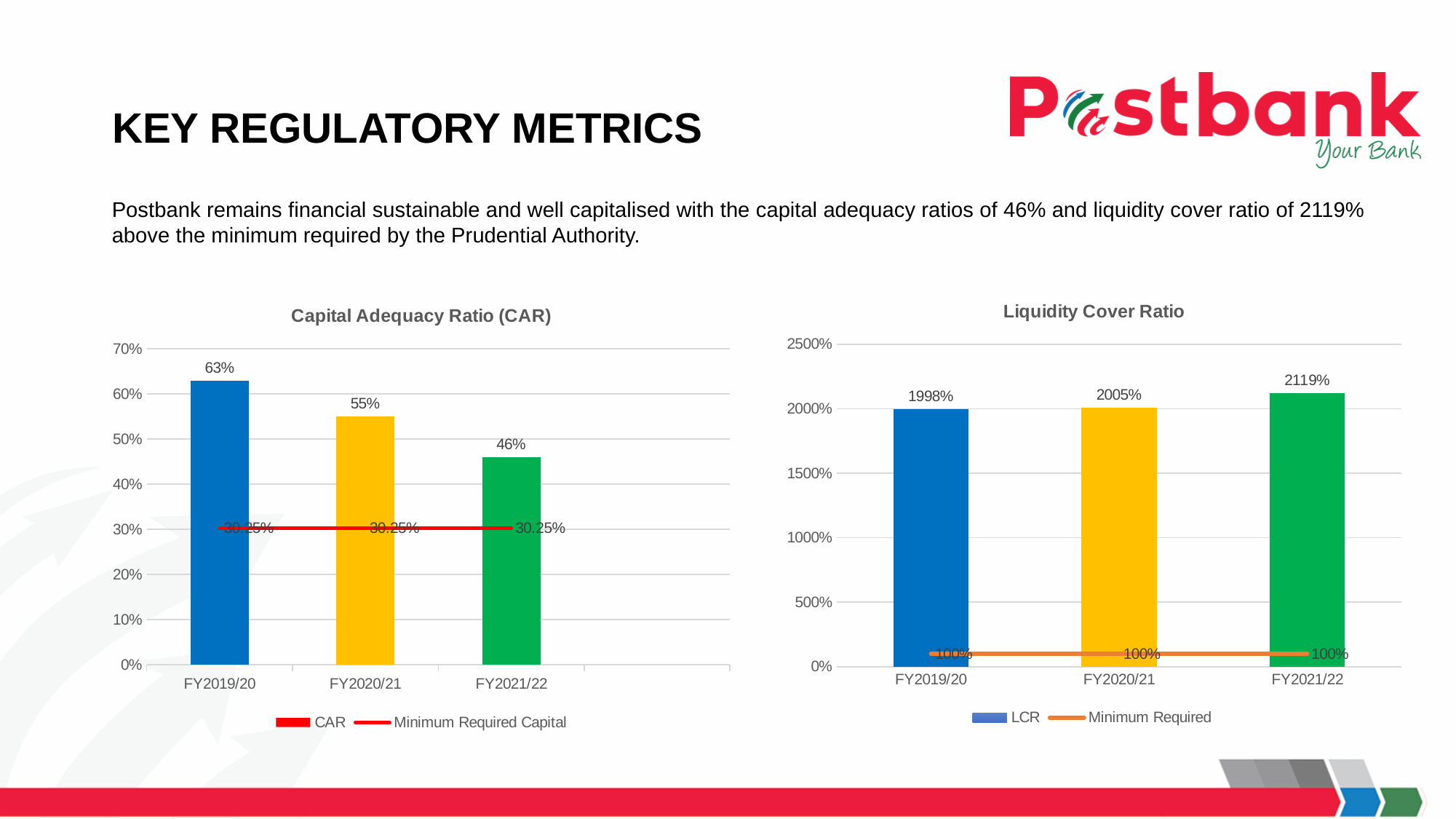
In the Liquidity Cover Ratio chart, do the LCR values rise or fall from FY2019/20 to FY2021/22? rise In the Liquidity Cover Ratio chart, what is the LCR value for FY2021/22? 2119% In the Capital Adequacy Ratio (CAR) chart, which fiscal year has the lowest CAR? FY2021/22 In the Capital Adequacy Ratio (CAR) chart, what is the Minimum Required Capital value shown for FY2021/22? 30.25% In the Liquidity Cover Ratio chart, which fiscal year has the lowest LCR? FY2019/20 How many series does the legend of the Liquidity Cover Ratio chart list? 2 In the Liquidity Cover Ratio chart, what is the difference between the LCR for FY2021/22 and FY2020/21? 114% How many fiscal years are shown on the x axis of the Liquidity Cover Ratio chart? 3 In the Capital Adequacy Ratio (CAR) chart, do the CAR values rise or fall from FY2019/20 to FY2021/22? fall In the Capital Adequacy Ratio (CAR) chart, which fiscal year has the highest CAR? FY2019/20 In the Capital Adequacy Ratio (CAR) chart, what is the CAR value for FY2020/21? 55% In the Capital Adequacy Ratio (CAR) chart, what is the difference between the CAR for FY2019/20 and FY2021/22? 17%